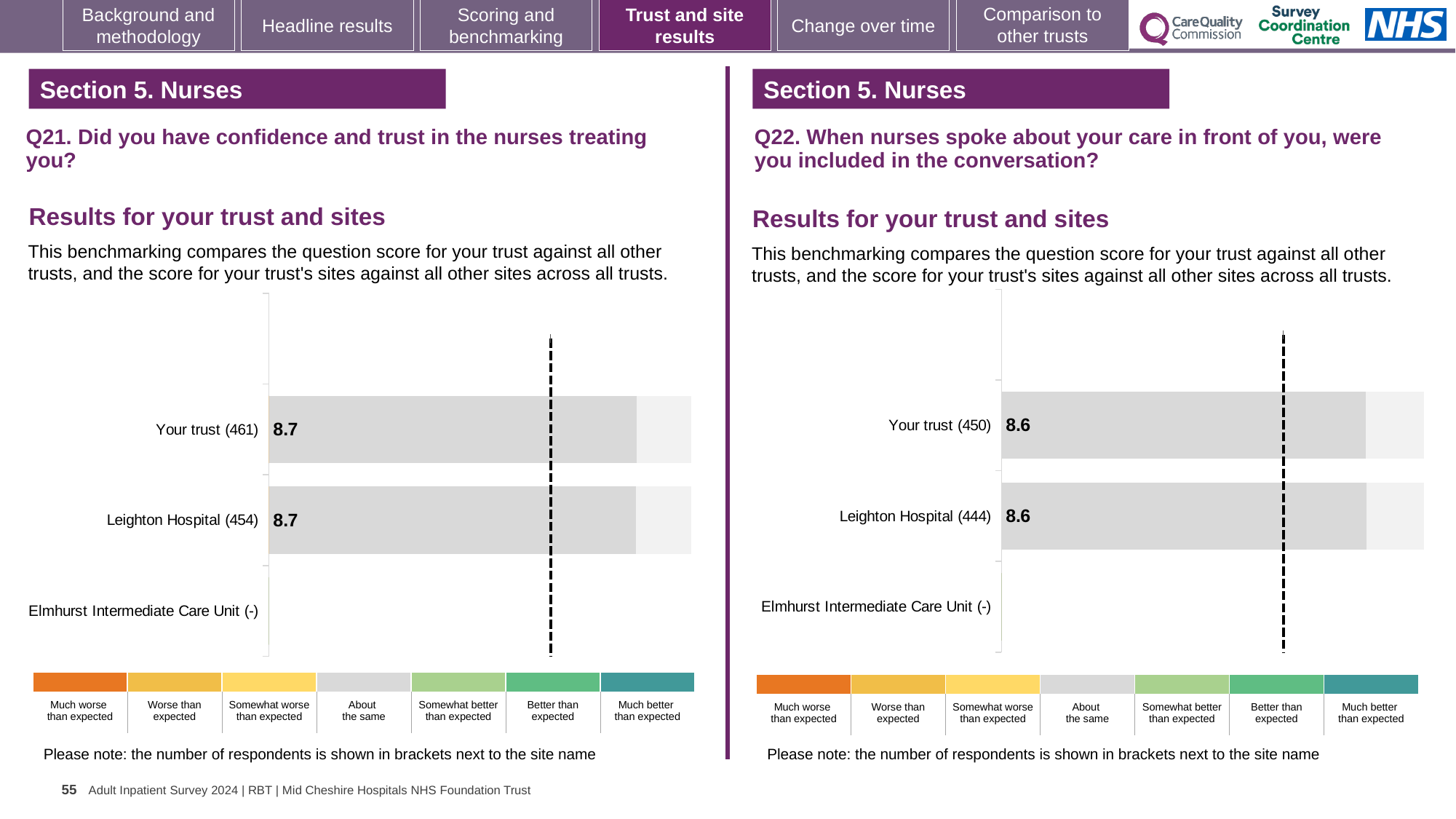
In the Q21 chart on the left, which category has no score shown? Elmhurst Intermediate Care Unit In the Q21 chart on the left, what is the score for Leighton Hospital? 8.7 In the Q21 chart on the left, what is the difference between the score for Your trust and the score for Leighton Hospital? 0 In the Q21 chart on the left, what is the score for Your trust? 8.7 In the Q22 chart on the right, what is the difference between the score for Your trust and the score for Leighton Hospital? 0 What kind of chart is the Q21 chart on the left? Bar chart In the Q22 chart on the right, what is the score for Your trust? 8.6 In the Q21 chart on the left, how many respondents are shown in brackets for Your trust? 461 In the Q22 chart on the right, how many respondents are shown in brackets for Leighton Hospital? 444 Which question does the chart on the right relate to? Q22. When nurses spoke about your care in front of you, were you included in the conversation? In the Q22 chart on the right, what is the score for Leighton Hospital? 8.6 How many categories are listed on the y axis of the Q22 chart on the right? 3